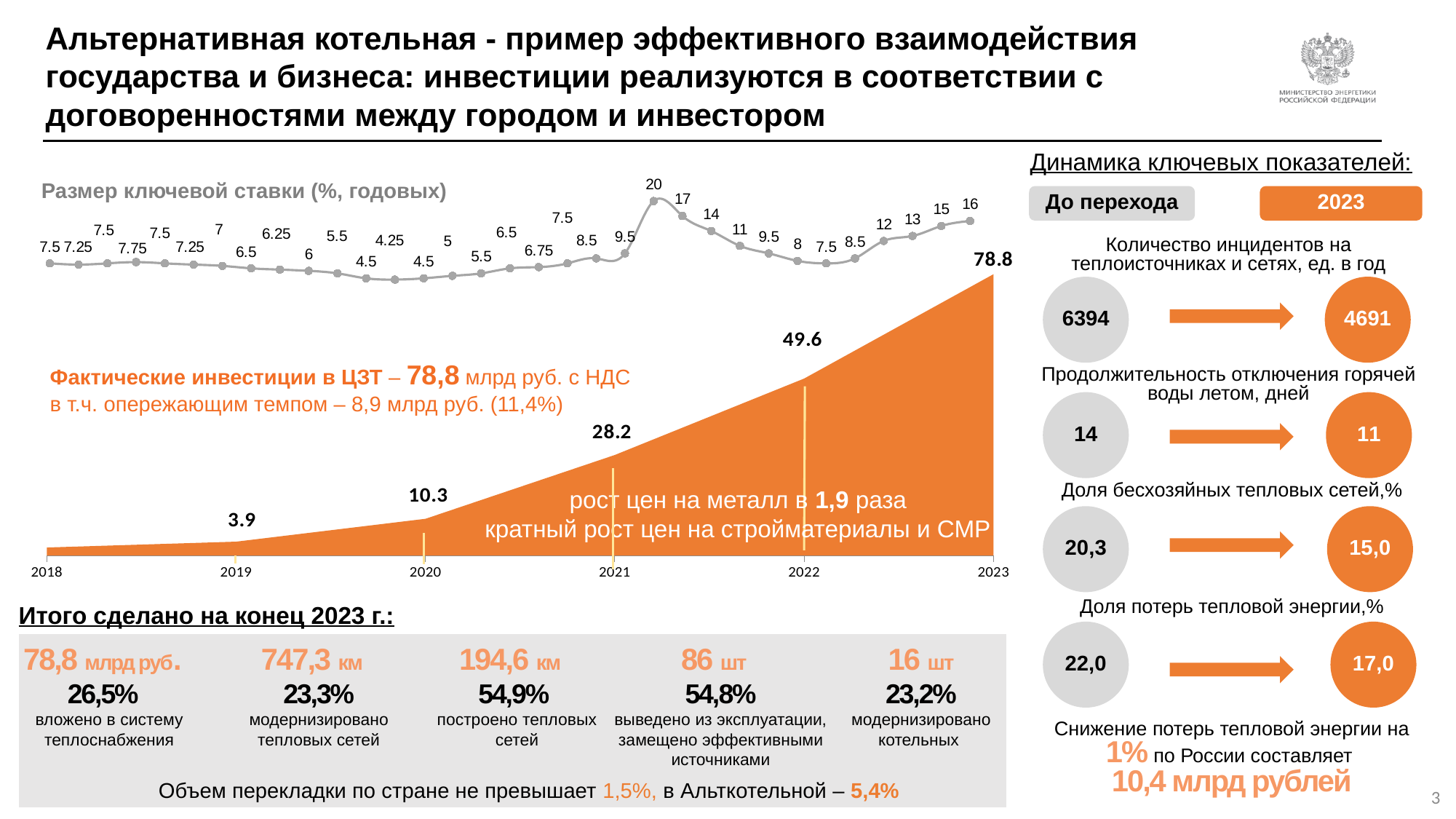
On the orange area chart of investments, what is the value labelled for 2022? 49.6 On the key rate line chart (Размер ключевой ставки), what is the lowest value labelled? 4.25 On the orange area chart of investments, do the values rise or fall from 2018 to 2023? rise On the orange area chart of investments, what is the value labelled for 2021? 28.2 What is the title of the grey line chart above the investments area? Размер ключевой ставки (%, годовых) On the orange area chart of investments, which year has the larger value, 2019 or 2020? 2020 On the orange area chart of investments, what is the value labelled for 2019? 3.9 On the orange area chart of investments, what is the difference between the 2021 value and the 2020 value? 17.9 What kind of chart is the orange investments chart? area chart On the orange area chart of investments, what is the difference between the 2023 value and the 2022 value? 29.2 How many years are labelled on the x axis of the investments chart? 6 On the key rate line chart (Размер ключевой ставки), what is the highest value labelled? 20